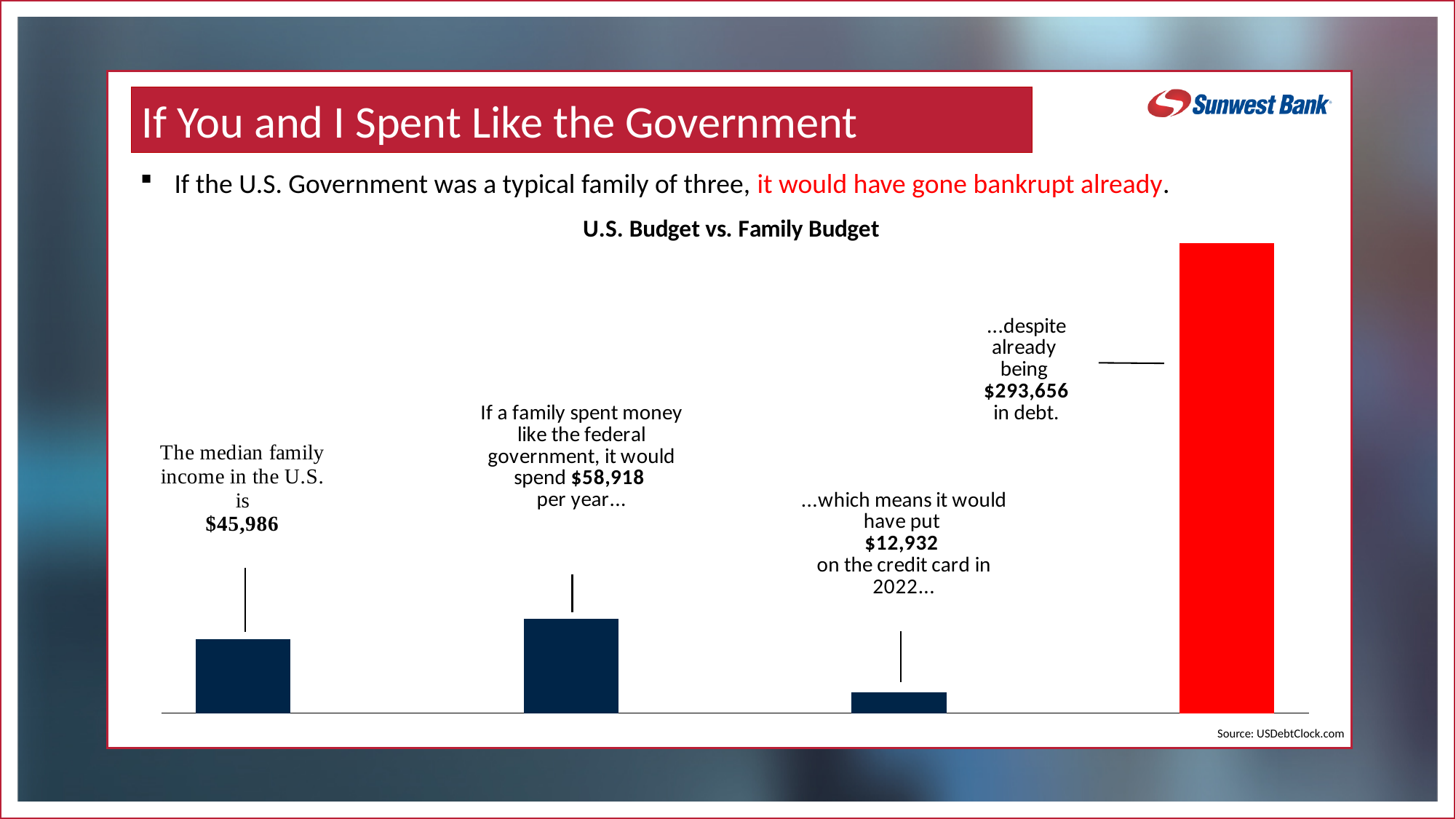
How much would the family have put on the credit card in 2022? $12,932 Which bar in the chart is the shortest? the credit card bar ($12,932) Which bar in the chart is the tallest? the debt bar ($293,656) What kind of chart is shown on the slide? bar chart Which is larger: the median family income or the amount the family would spend per year? the amount the family would spend per year ($58,918) What is the median family income in the U.S. shown in the chart? $45,986 How much would a family spend per year if it spent money like the federal government? $58,918 What is the title of the chart? U.S. Budget vs. Family Budget What colour is the bar representing the $293,656 debt? red How much debt is the family already in, according to the chart? $293,656 How many bars are plotted in the chart? 4 What is the difference between the family's spending ($58,918) and the median family income ($45,986)? $12,932